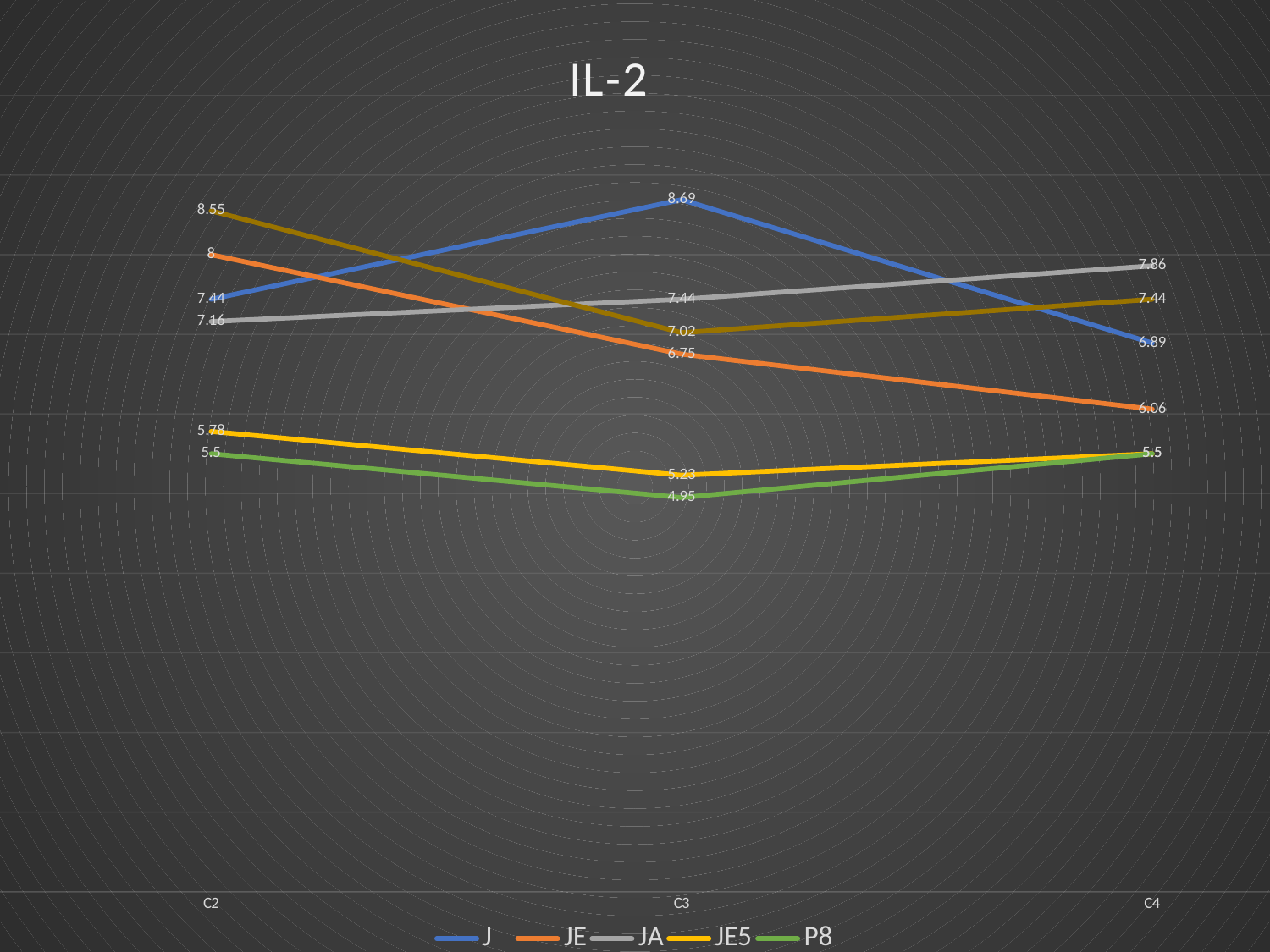
What type of chart is shown on the slide? line chart At C4, which series has the larger value, JA or J? JA How many categories are shown on the x axis? 3 What is the value of series J at C3? 8.69 At which category does series JE5 have its lowest value? C3 What is the title of the chart? IL-2 What is the difference between the JE values at C2 and C4? 1.94 How many series does the legend list? 5 What is the value of series P8 at C3? 4.95 What is the value of series JA at C2? 7.16 What is the value of series JE at C4? 6.06 At which category does series J reach its highest value? C3